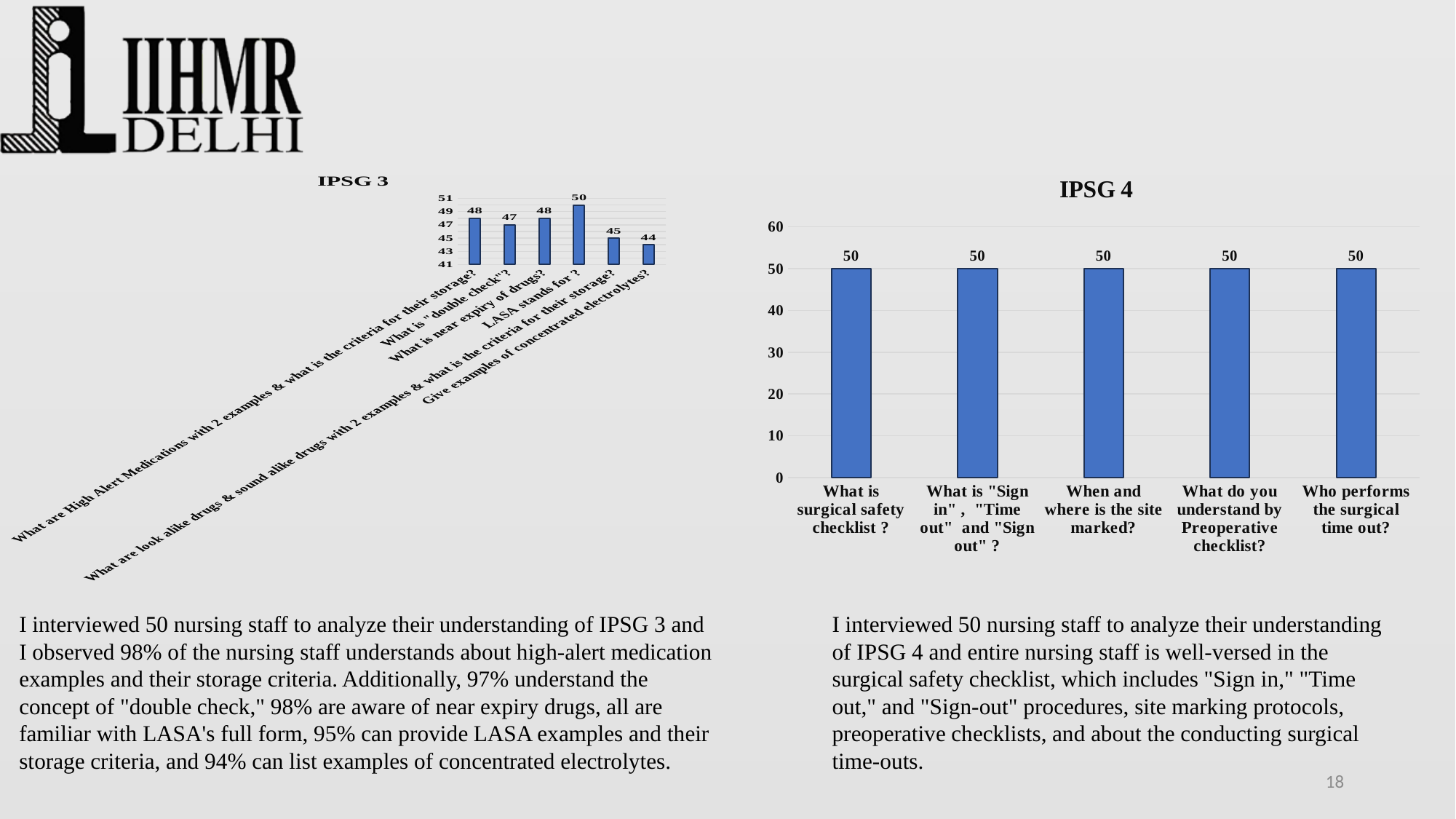
In the IPSG 4 chart, what is the value for "Who performs the surgical time out?"? 50 How many categories are plotted in the IPSG 4 chart? 5 In the IPSG 3 chart, which category has the lowest value? Give examples of concentrated electrolytes? How many categories are plotted in the IPSG 3 chart? 6 In the IPSG 3 chart, which category has the highest value? LASA stands for ? In the IPSG 3 chart, what is the difference between the value for "LASA stands for ?" and the value for "Give examples of concentrated electrolytes?"? 6 In the IPSG 3 chart, what is the value for "What is "double check"?"? 47 In the IPSG 3 chart, which is larger: the value for "What is near expiry of drugs?" or the value for "What is "double check"?"? What is near expiry of drugs? What kind of chart is the IPSG 4 chart? Bar chart In the IPSG 4 chart, is the value for "When and where is the site marked?" greater or less than 40? greater In the IPSG 3 chart, what is the value for "LASA stands for ?"? 50 In the IPSG 3 chart, what is the value for "Give examples of concentrated electrolytes?"? 44